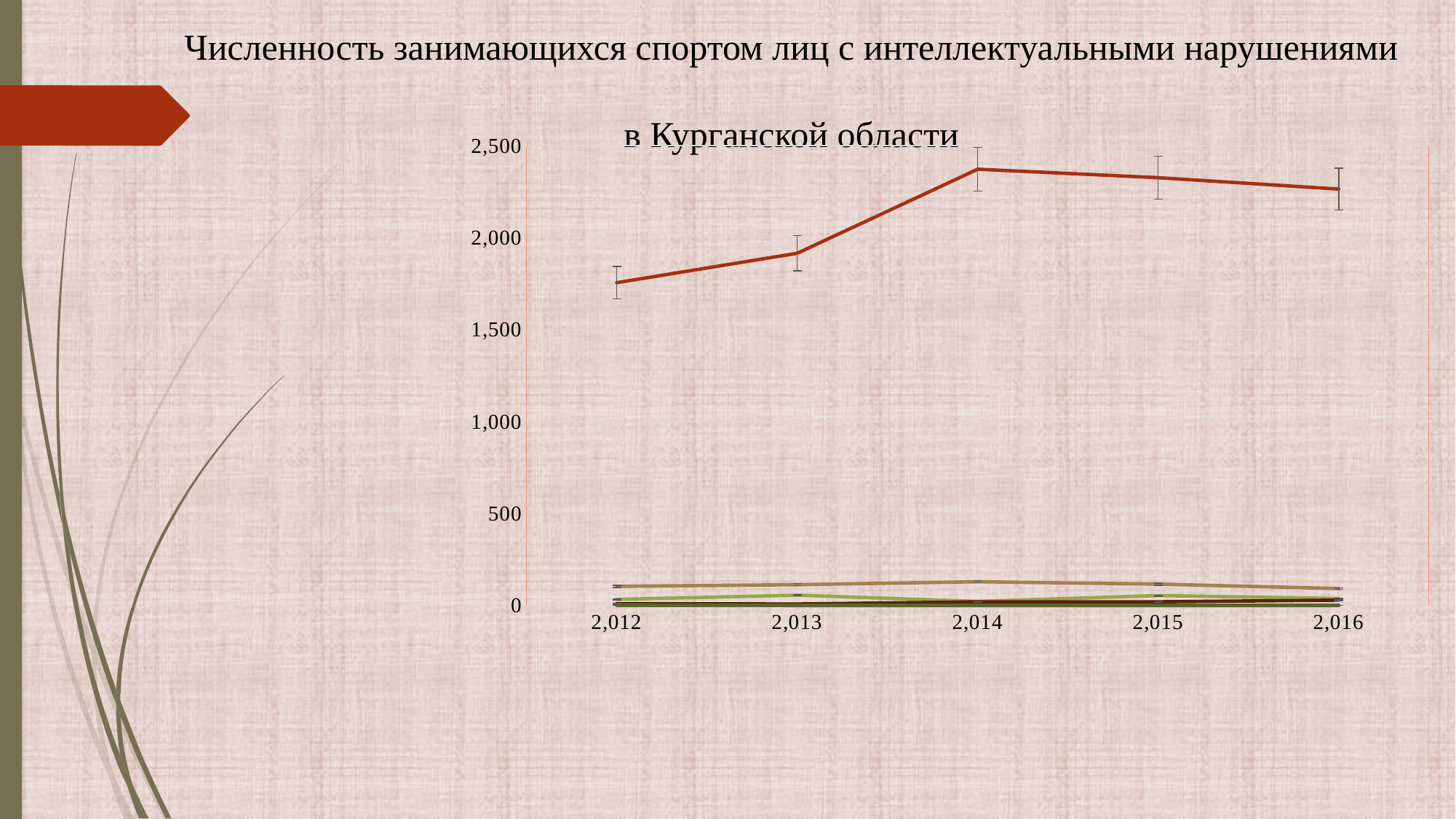
What is the title of the chart? Численность занимающихся спортом лиц с интеллектуальными нарушениями в Курганской области Is the value of the top (red) line for 2,014 greater or less than 2,000? greater For the top (red) line, which year has the larger value, 2,012 or 2,014? 2,014 Is the value of the top (red) line for 2,016 greater or less than 2,000? greater Does the top (red) line rise or fall from 2,014 to 2,016? fall In which year does the top (red) line reach its highest value? 2,014 Does the top (red) line rise or fall from 2,012 to 2,014? rise What kind of chart is shown on the slide? line chart In which year does the top (red) line have its lowest value? 2,012 Is the value of the top (red) line for 2,012 greater or less than 1,500? greater How many years are shown on the x axis? 5